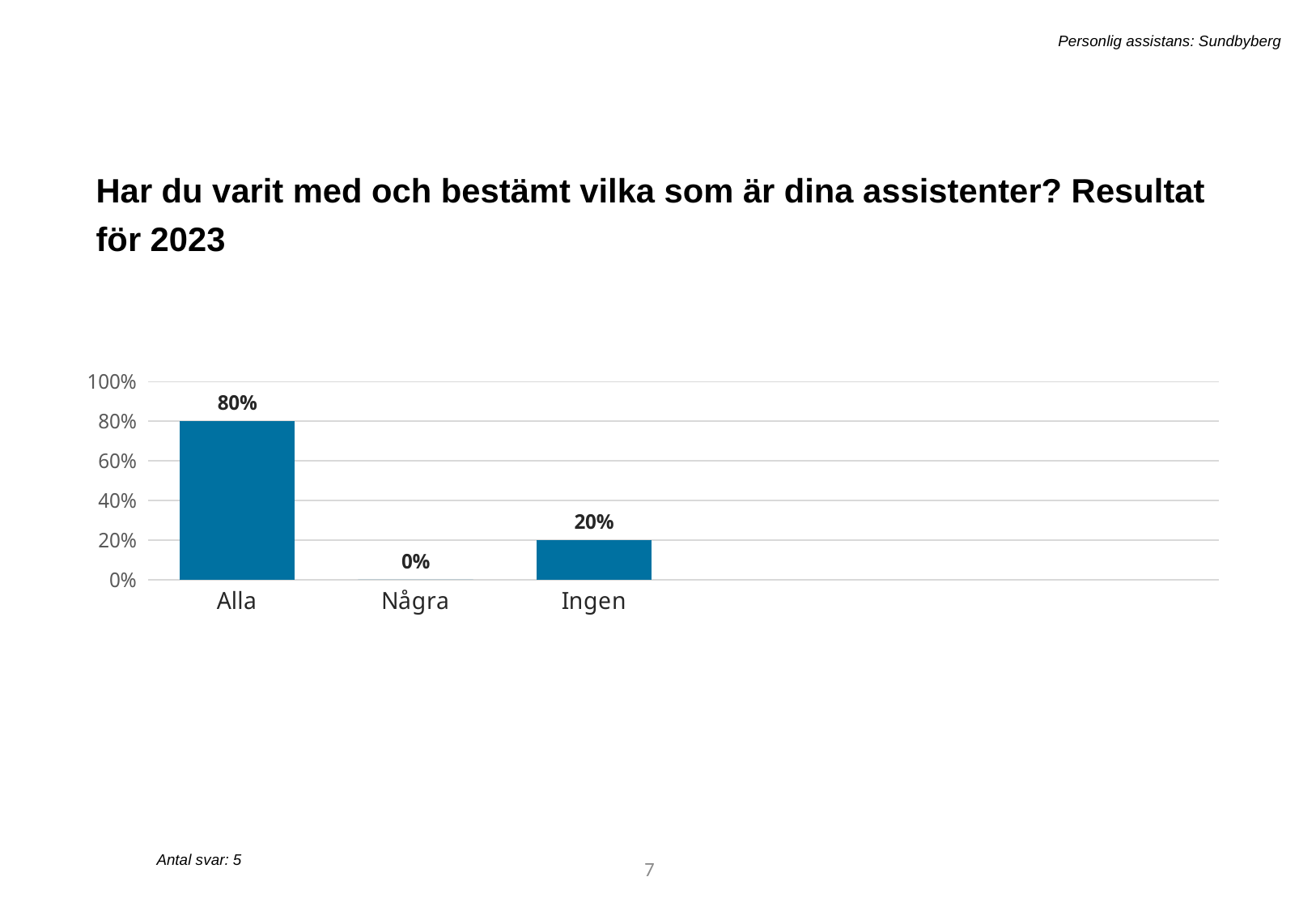
How many responses (Antal svar) does the slide report? 5 What kind of chart is shown on the slide? bar chart What is the highest value shown on the y axis? 100% What is the difference between the values for Alla and Ingen? 60% What is the value for Alla? 80% What is the value for Ingen? 20% Is the value for Alla greater or less than 60%? greater Which is larger, the value for Ingen or the value for Några? Ingen How many categories are shown on the x axis? 3 Which category has the lowest value? Några What is the value for Några? 0% Which category has the highest value? Alla